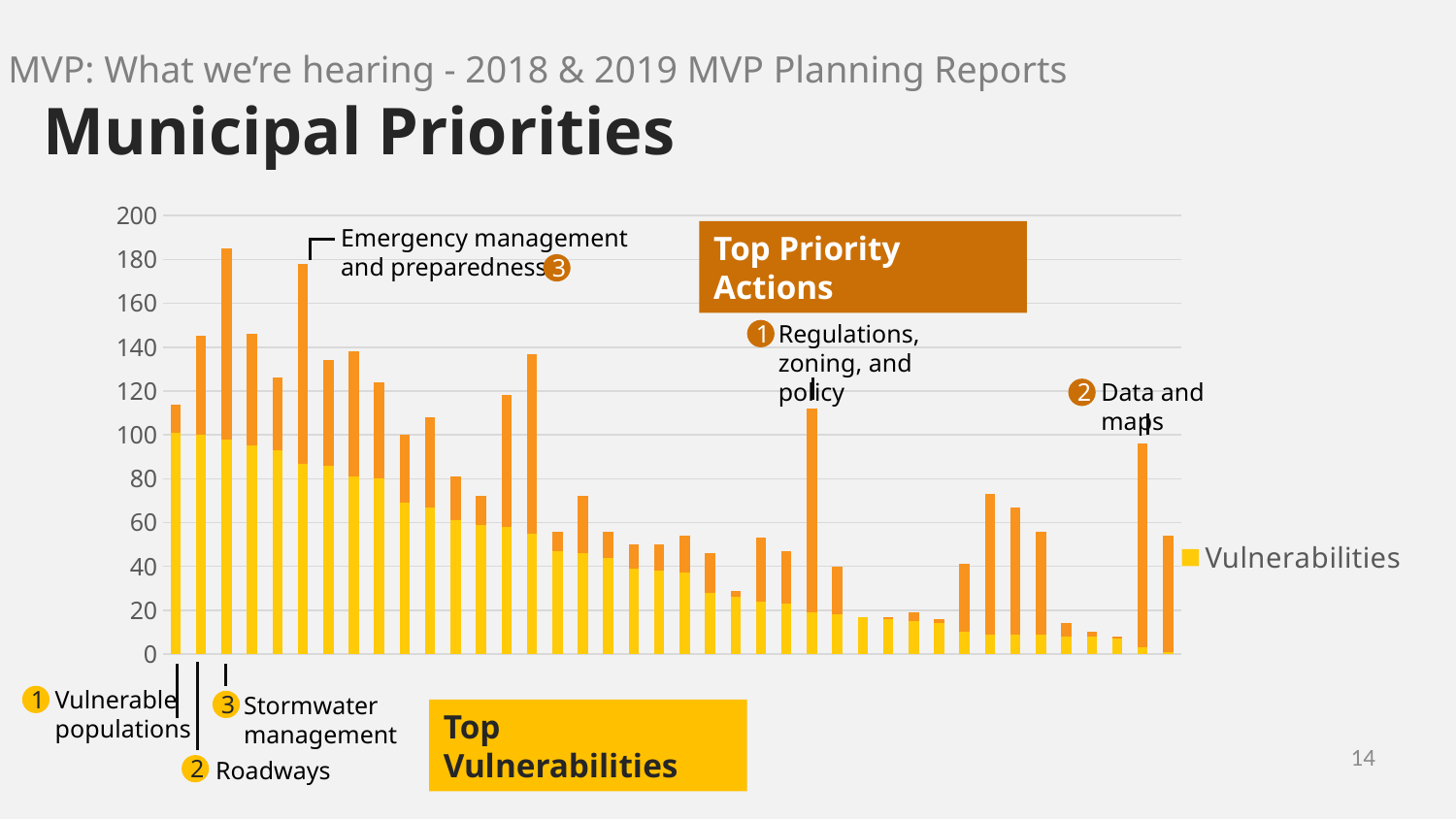
Is the total height of the bar annotated 'Data and maps' greater or less than 80? greater What kind of chart is shown on the slide? bar chart Which bar is taller: the one annotated 'Emergency management and preparedness' or the one annotated 'Data and maps'? Emergency management and preparedness Which series name is shown in the chart's legend? Vulnerabilities Is the tallest bar in the chart greater or less than 180? greater Which bar is taller: the one annotated 'Regulations, zoning, and policy' or the one annotated 'Data and maps'? Regulations, zoning, and policy Is the total height of the bar annotated 'Regulations, zoning, and policy' greater or less than 100? greater What colour represents the Vulnerabilities series in the chart? yellow What is the highest value shown on the chart's vertical axis? 200 Do the bar heights generally rise or fall from left to right along the x axis? fall